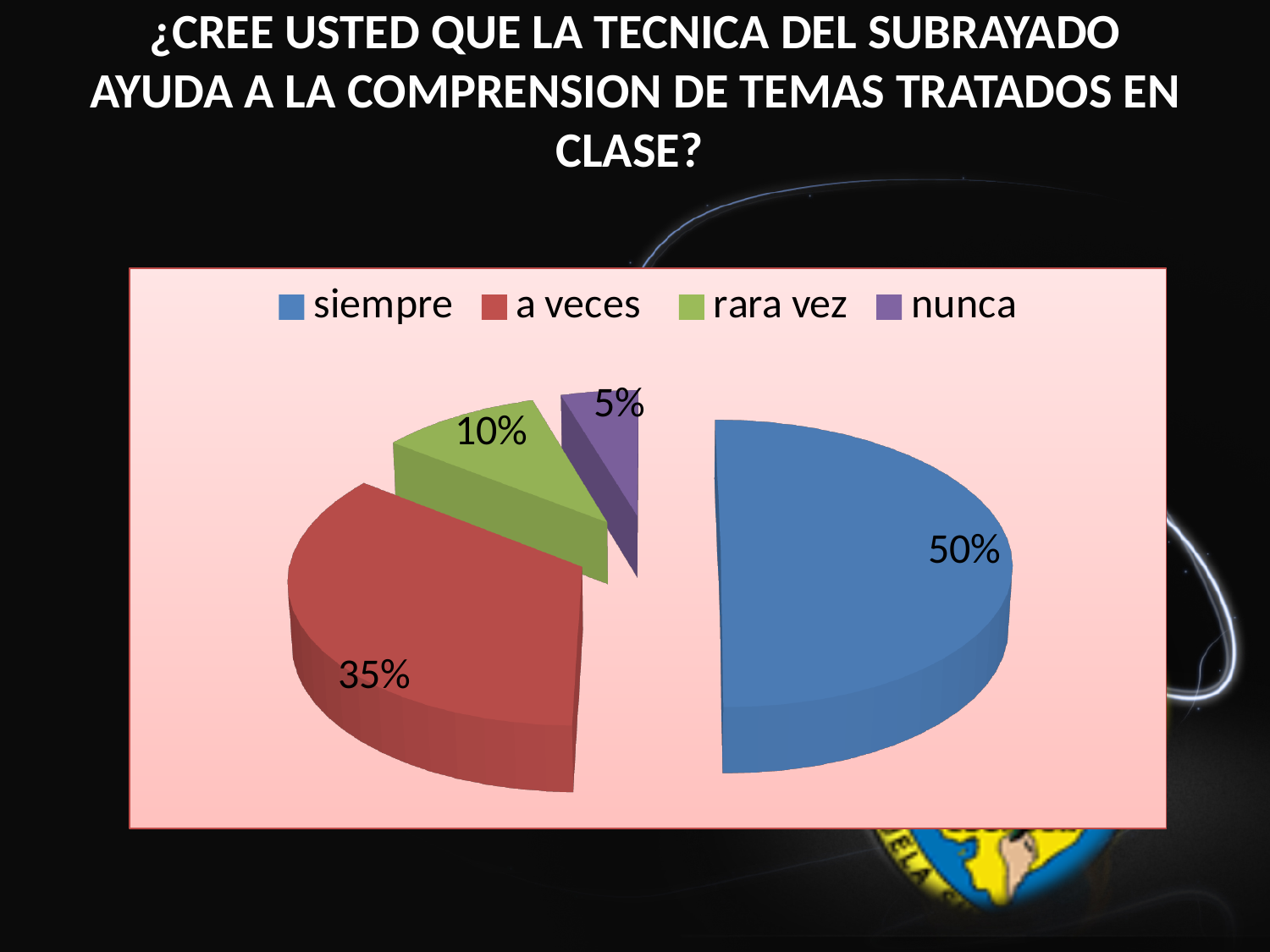
What percentage of the pie does 'siempre' represent? 50% What is the difference in percentage points between 'siempre' and 'a veces'? 15 What kind of chart is shown on the slide? pie chart What is the combined share of 'rara vez' and 'nunca'? 15% What percentage of the pie does 'rara vez' represent? 10% What percentage of the pie does 'nunca' represent? 5% What percentage of the pie does 'a veces' represent? 35% Which category has the largest share of the pie? siempre Which category has the smallest share of the pie? nunca What colour is the slice for 'a veces'? red How many categories does the pie chart show? 4 Which is larger, the share for 'rara vez' or the share for 'nunca'? rara vez